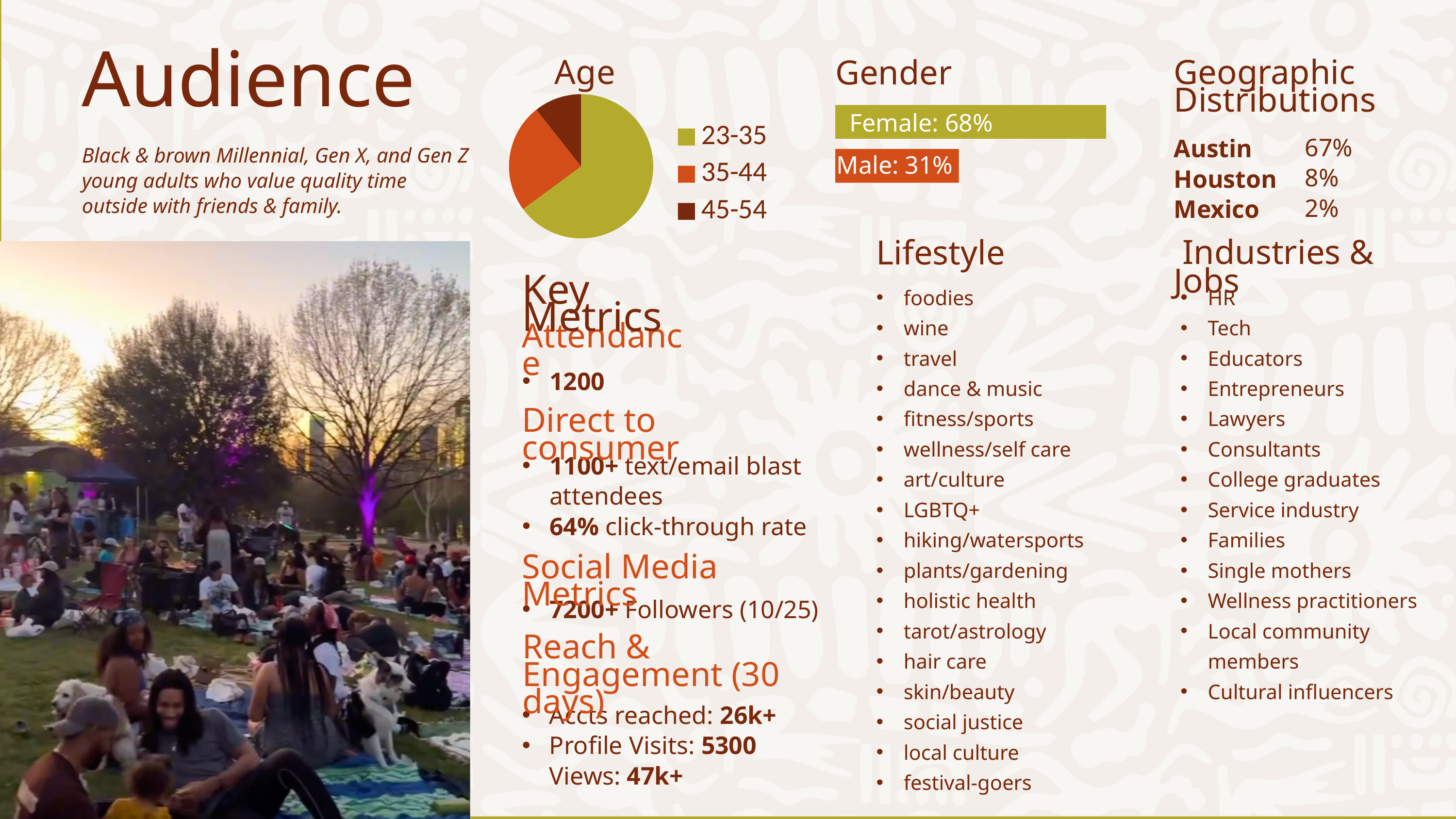
Which age group is shown in the olive green colour in the Age pie chart? 23-35 How many slices does the Age pie chart have? 3 In the Age pie chart, which slice is larger: 35-44 or 45-54? 35-44 Which age group has the smallest slice in the Age pie chart? 45-54 How many entries does the legend of the Age pie chart list? 3 Which age group has the largest slice in the Age pie chart? 23-35 What kind of chart is the Age chart? pie chart In the Age pie chart, which slice is larger: 23-35 or 35-44? 23-35 What is the title of the pie chart on the slide? Age